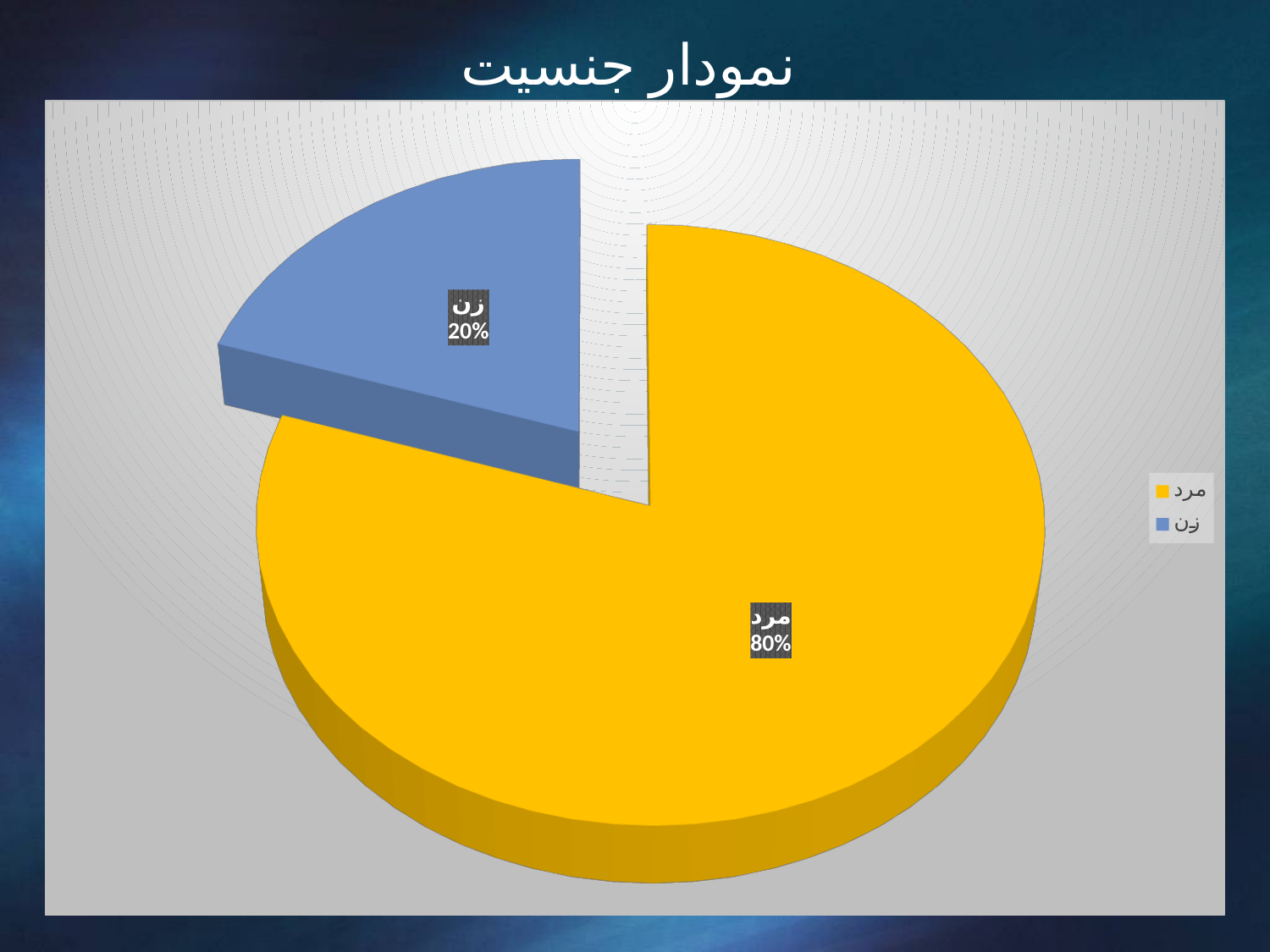
What colour is the زن slice? Blue What share of the pie does the مرد slice represent? 80% Which slice is larger, مرد or زن? مرد Which category has the smallest slice of the pie? زن What is the difference in percentage points between the مرد and زن slices? 60% How many entries does the legend list? 2 What is the title of the chart? نمودار جنسیت What share of the pie does the زن slice represent? 20% What kind of chart is shown on the slide? Pie chart Which category has the largest slice of the pie? مرد How many slices does the pie chart have? 2